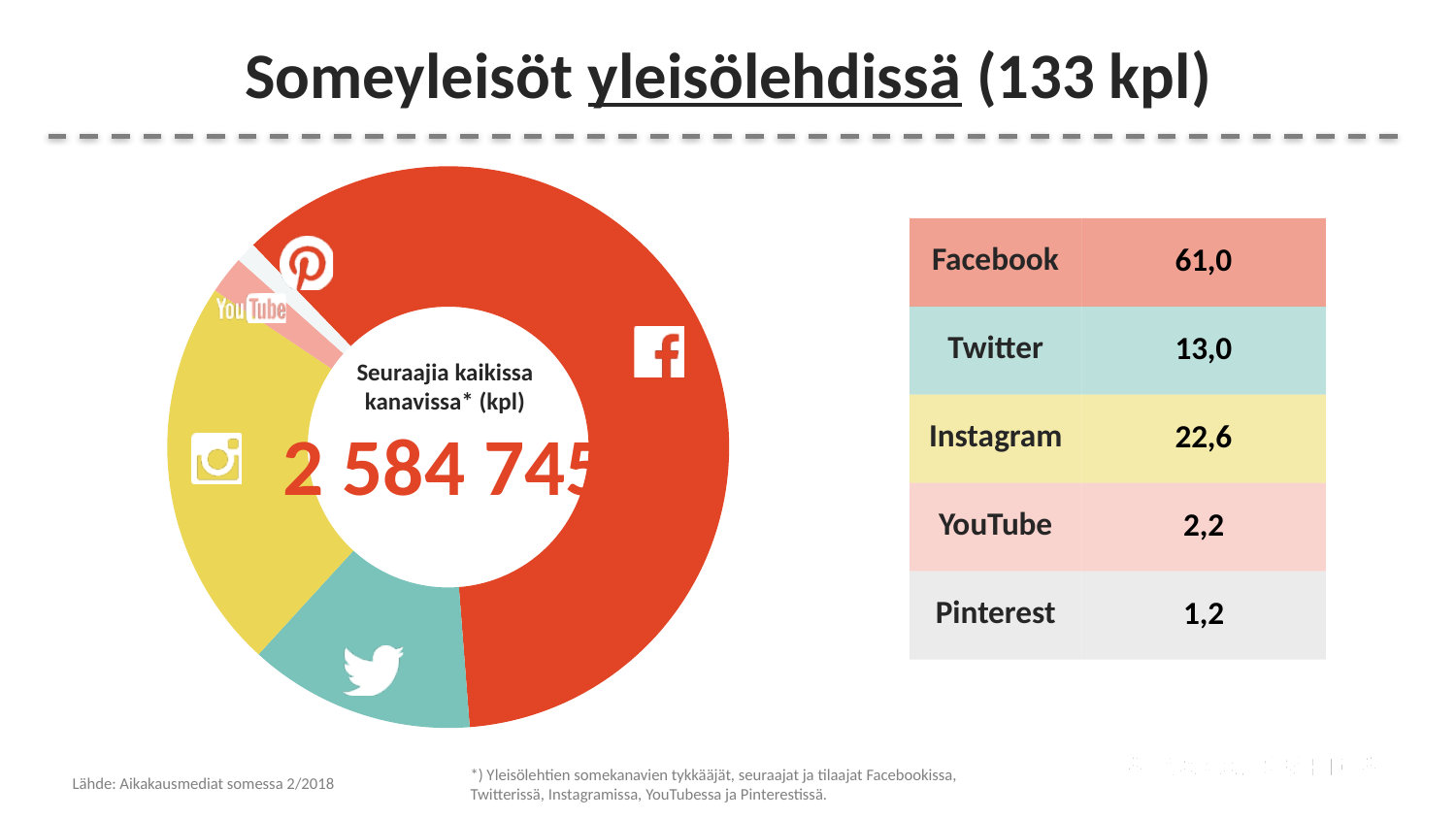
What kind of chart is shown on the slide? Donut (pie) chart Which channel has the largest slice of the donut chart? Facebook Which channel has the smallest slice of the donut chart? Pinterest What value is shown for Pinterest in the table next to the donut chart? 1,2 What is the difference between the values for Facebook and Instagram? 38,4 What value is shown for Facebook in the table next to the donut chart? 61,0 Which is larger, the value for Twitter or the value for Instagram? Instagram What value is shown for YouTube in the table next to the donut chart? 2,2 What total number of followers across all channels is printed in the centre of the donut chart? 2 584 745 What is the difference between the values for Instagram and Twitter? 9,6 What value is shown for Instagram in the table next to the donut chart? 22,6 How many channels are shown in the donut chart? 5